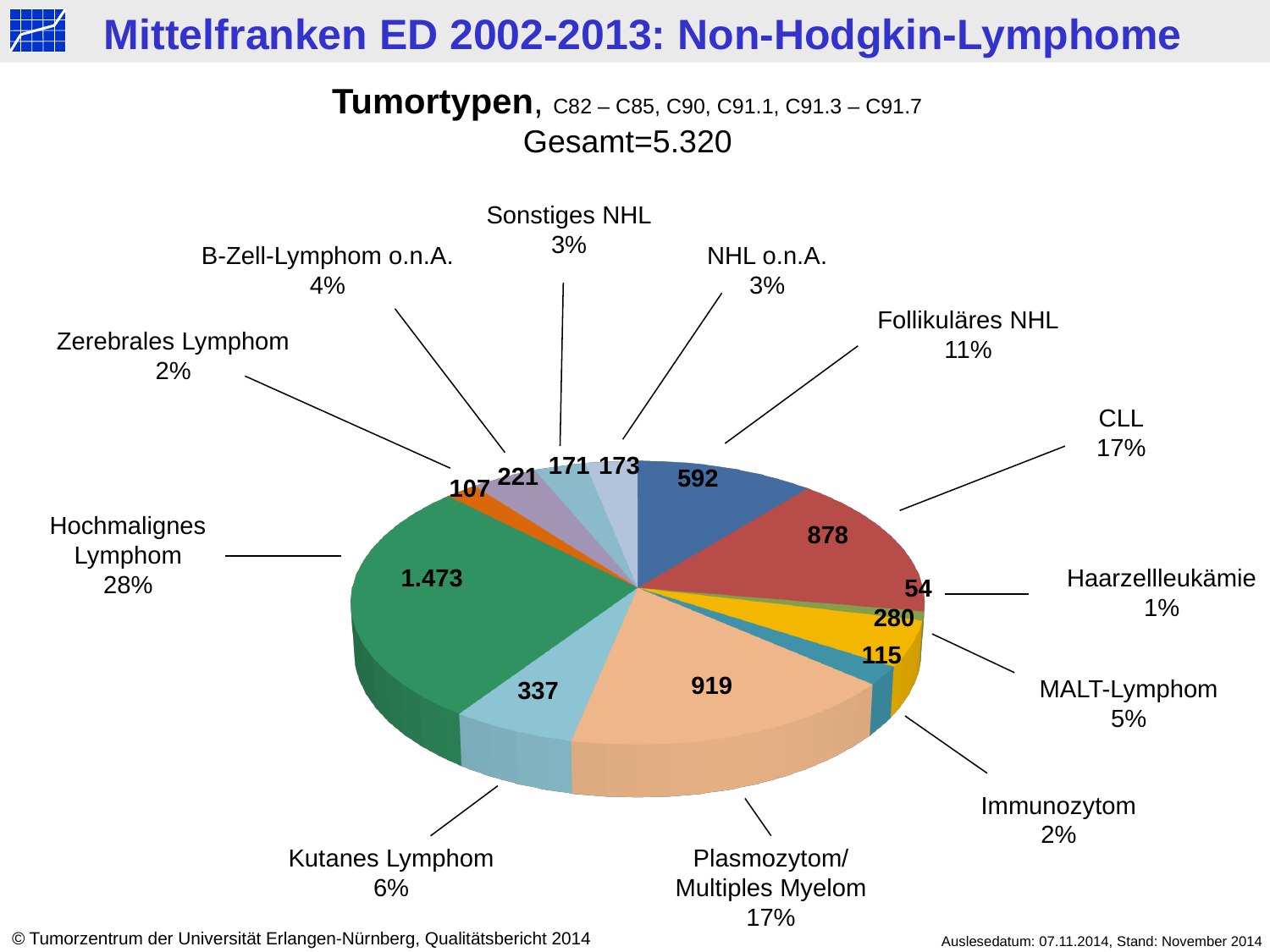
What percentage share does Follikuläres NHL have? 11% How many tumour type categories does the pie chart show? 12 What is the value shown for CLL? 878 Which tumour type has the smallest slice of the pie? Haarzellleukämie What is the value shown for Hochmalignes Lymphom? 1.473 Which tumour type has the largest slice of the pie? Hochmalignes Lymphom What is the total number of cases (Gesamt) given above the pie chart? 5.320 What percentage share does Kutanes Lymphom have? 6% What is the difference between the values for Hochmalignes Lymphom and Plasmozytom/Multiples Myelom? 554 What type of chart is shown on the slide? pie chart Which has the larger value, MALT-Lymphom or Kutanes Lymphom? Kutanes Lymphom What is the value shown for Plasmozytom/Multiples Myelom? 919